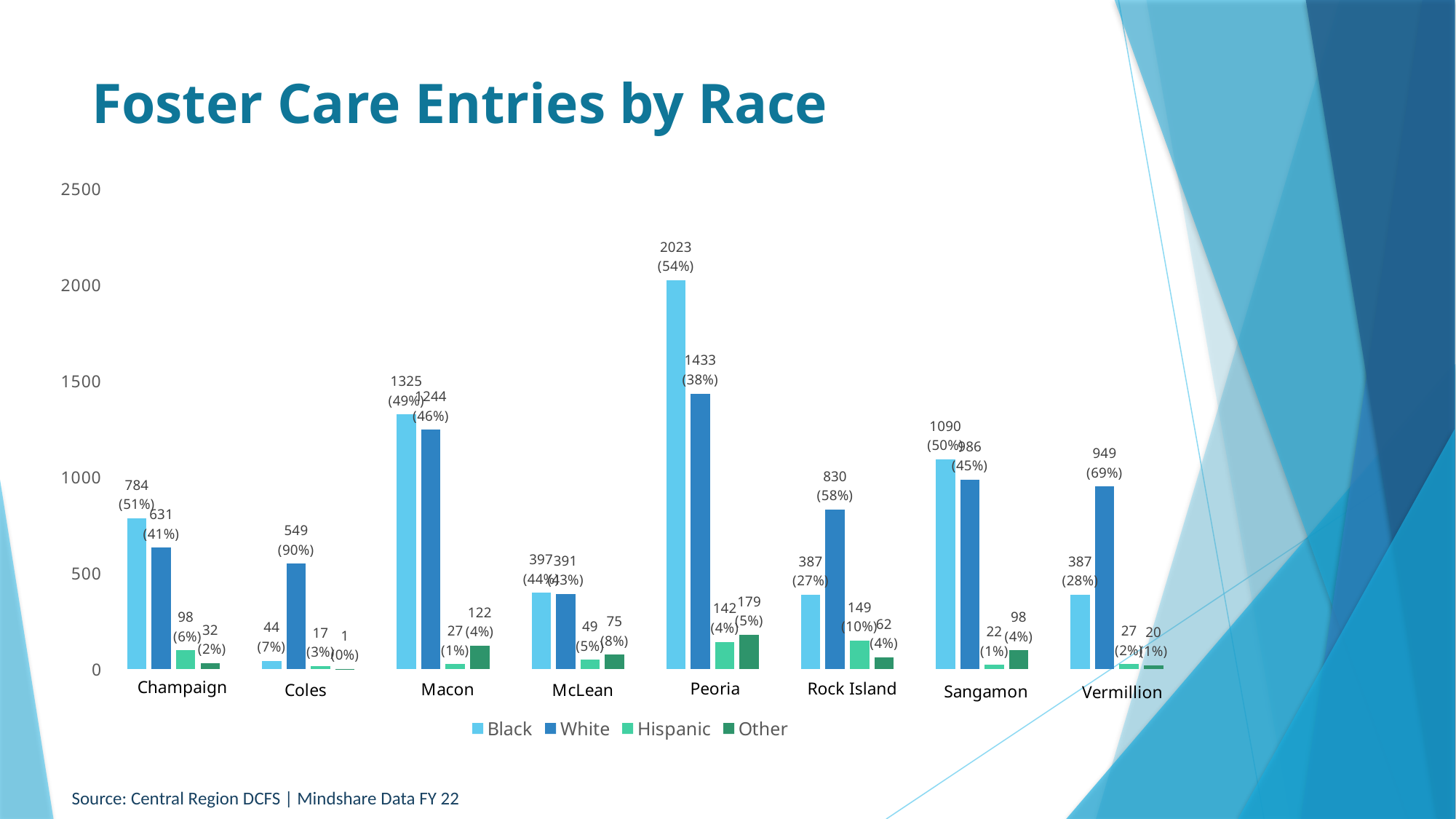
What is the value for Black in Peoria? 2023 What kind of chart is shown on the slide? Bar chart Which county has the highest value for Black? Peoria How many series does the legend list? 4 What is the value for Hispanic in Rock Island? 149 Which is larger in Rock Island, the Black value or the White value? White What is the value for White in Coles? 549 What is the difference between the Black and White values in Peoria? 590 Which county has the lowest value for Other? Coles What percentage is shown for White in Vermillion? 69% How many counties are shown on the x axis? 8 What is the title of the chart? Foster Care Entries by Race